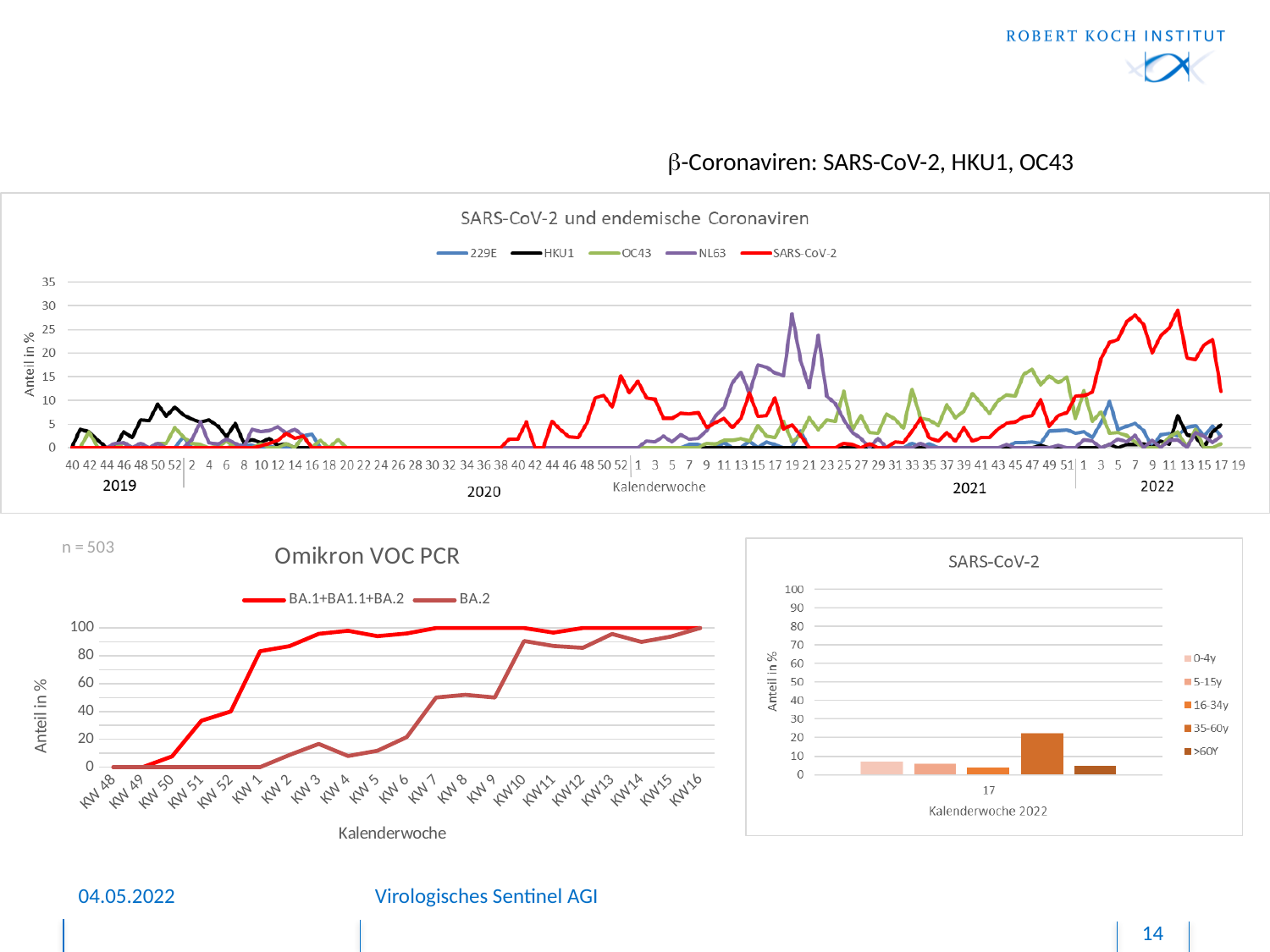
In the 'Omikron VOC PCR' chart, is the value of BA.2 at KW10 greater or less than 80? greater How many series does the legend of the top chart 'SARS-CoV-2 und endemische Coronaviren' list? 5 What kind of chart is the top chart titled 'SARS-CoV-2 und endemische Coronaviren'? line chart How many series does the legend of the 'Omikron VOC PCR' chart list? 2 What is the x-axis label of the 'Omikron VOC PCR' chart? Kalenderwoche In the bottom-right 'SARS-CoV-2' bar chart, is the value for 0-4y greater or less than 10? less What kind of chart is the bottom-right chart titled 'SARS-CoV-2'? bar chart In the top chart 'SARS-CoV-2 und endemische Coronaviren', is the highest value reached by the SARS-CoV-2 line greater or less than 25? greater In the 'Omikron VOC PCR' chart, does the BA.1+BA1.1+BA.2 line rise or fall from KW 48 to KW 16? rise In the top chart 'SARS-CoV-2 und endemische Coronaviren', which series is drawn in red? SARS-CoV-2 How many age groups are shown in the bottom-right 'SARS-CoV-2' bar chart? 5 In the bottom-right 'SARS-CoV-2' bar chart, which age group has the highest value? 35-60y